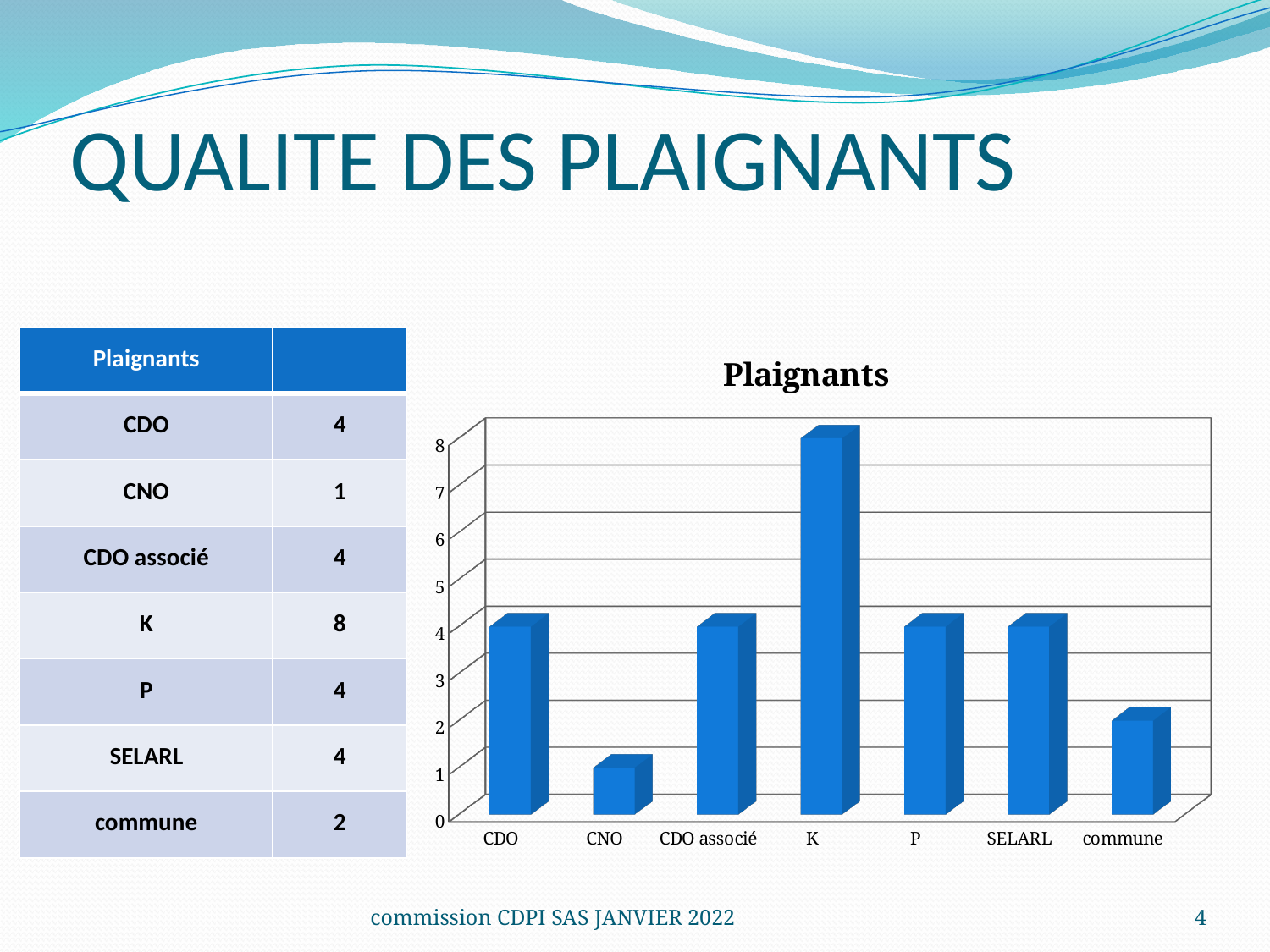
What is the value for commune in the Plaignants chart? 2 What is the difference between the values for K and commune in the Plaignants chart? 6 What is the value for CNO in the Plaignants chart? 1 What is the value for K in the Plaignants chart? 8 Which category has the highest value in the Plaignants chart? K How many categories are shown on the x axis of the Plaignants chart? 7 What is the value for SELARL in the Plaignants chart? 4 Which category has the lowest value in the Plaignants chart? CNO What is the difference between the values for CDO and CNO in the Plaignants chart? 3 Which is larger in the Plaignants chart, the value for P or the value for commune? P What is the title of the chart on the slide? Plaignants What kind of chart is shown on the slide? Bar chart